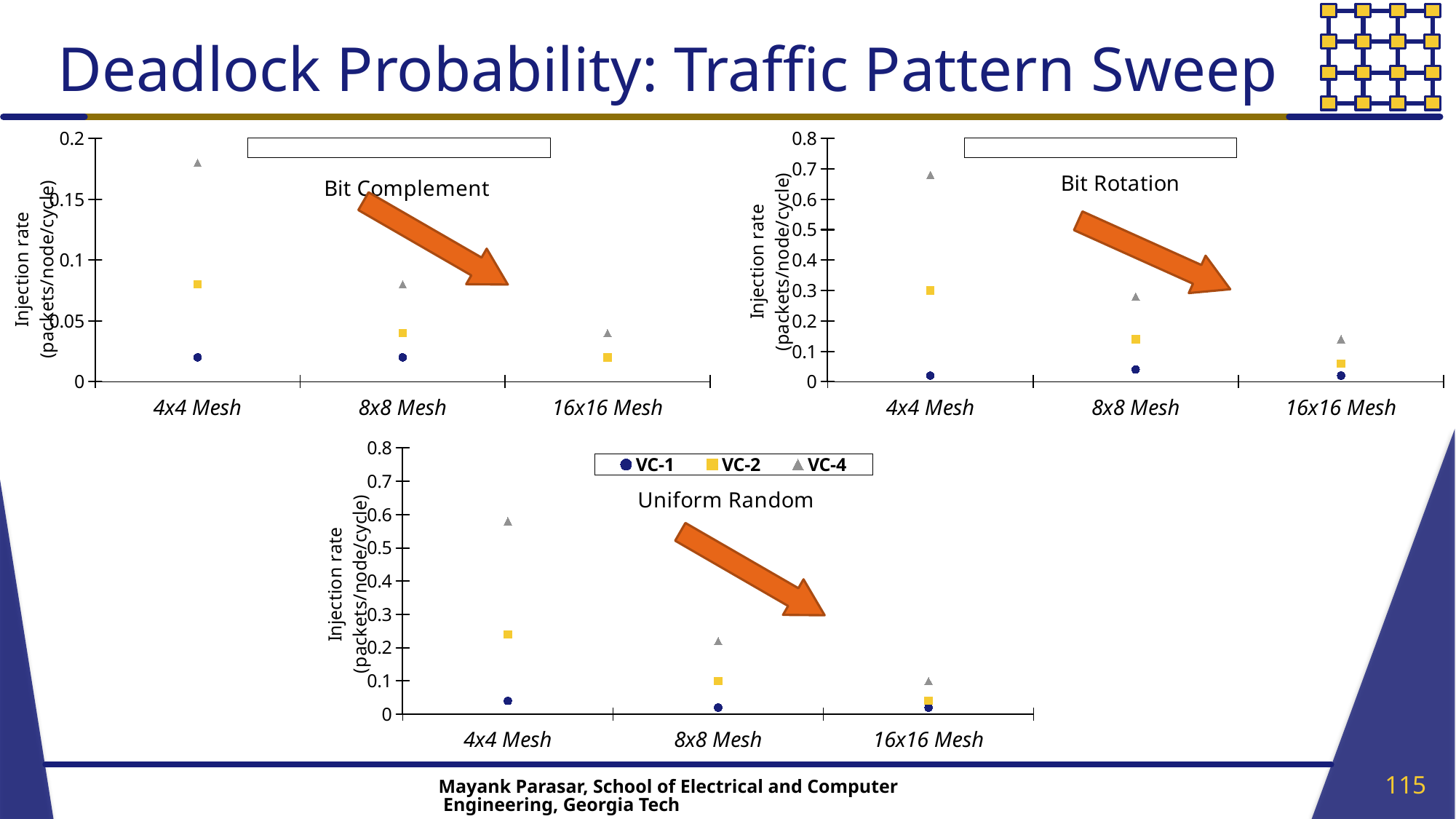
What kind of chart is the Bit Complement chart? scatter chart In the Uniform Random chart, is the VC-4 value for 4x4 Mesh greater or less than 0.5? greater How many mesh sizes are shown on the x axis of the Bit Rotation chart? 3 In the Bit Rotation chart, which series has the highest value at 4x4 Mesh? VC-4 In the Bit Rotation chart, is the VC-4 value for 4x4 Mesh greater or less than 0.6? greater In the Bit Complement chart, is the VC-4 value for 4x4 Mesh greater or less than 0.15? greater How many series does the legend on the Uniform Random chart list? 3 In the Bit Rotation chart, is the VC-2 value larger at 4x4 Mesh or at 16x16 Mesh? 4x4 Mesh What is the y-axis label on the Uniform Random chart? Injection rate (packets/node/cycle) In the Uniform Random chart, does the VC-4 value rise or fall from 4x4 Mesh to 16x16 Mesh? fall